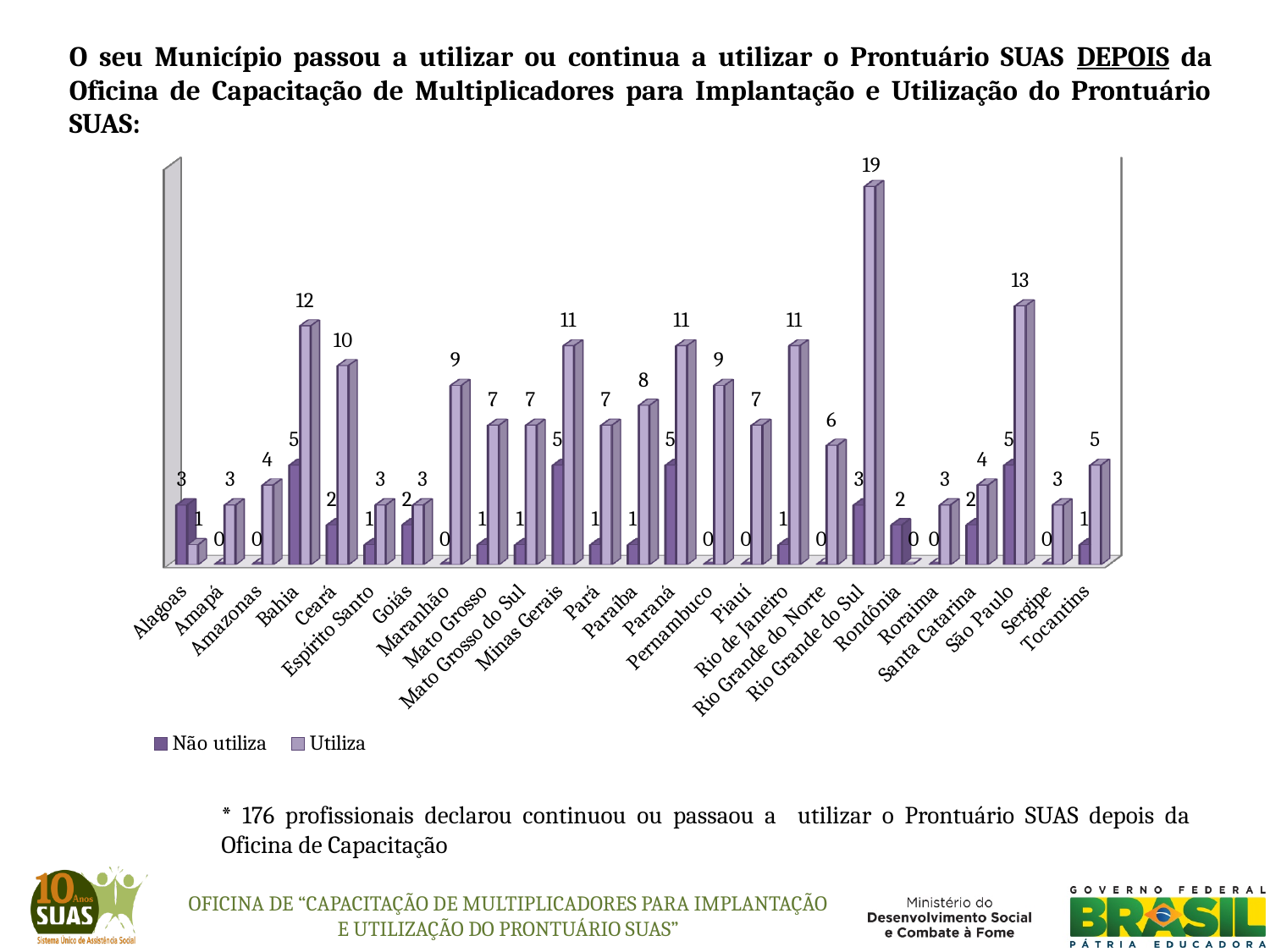
Which state has the highest 'Utiliza' value? Rio Grande do Sul What is the 'Utiliza' value for Ceará? 10 Which state has the lowest 'Utiliza' value? Rondônia What is the 'Não utiliza' value for Bahia? 5 What is the difference between the 'Utiliza' and 'Não utiliza' values for São Paulo? 8 What are the two legend entries of the chart? Não utiliza and Utiliza How many series does the legend list? 2 How many states are shown on the x axis? 25 What is the 'Utiliza' value for Rio Grande do Sul? 19 What is the 'Não utiliza' value for Rondônia? 2 Which is larger for Alagoas: 'Não utiliza' or 'Utiliza'? Não utiliza What kind of chart is shown on the slide? Bar chart